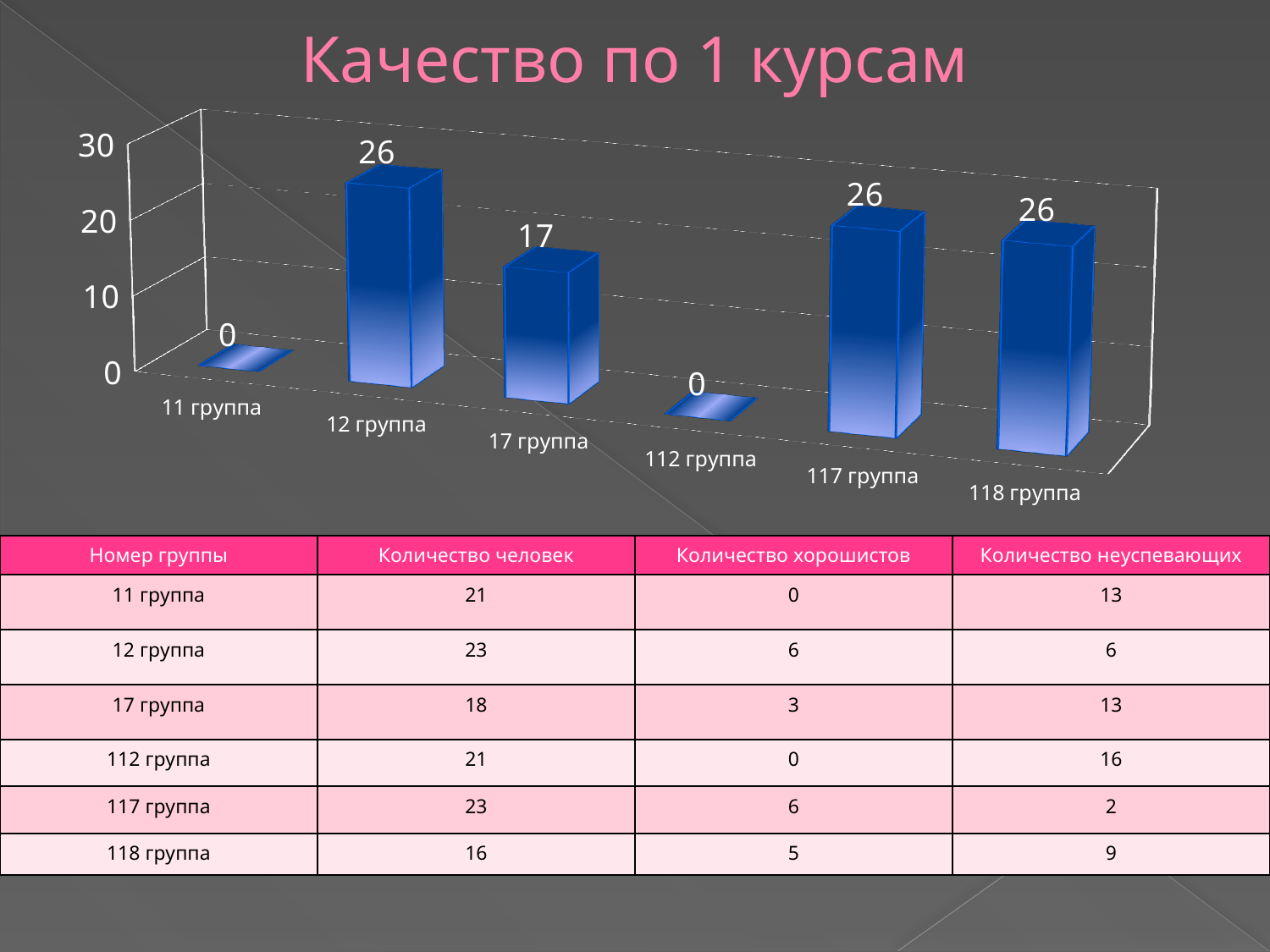
What is the difference between the values for 12 группа and 17 группа? 9 Is the value for 17 группа greater or less than 10? greater What is the value for 117 группа? 26 How many groups are shown on the chart? 6 What is the value for 118 группа? 26 What kind of chart is shown on the slide? bar chart What is the value for 12 группа? 26 What is the value for 112 группа? 0 Which is larger, the value for 12 группа or the value for 17 группа? 12 группа What is the title of the chart? Качество по 1 курсам What is the value for 17 группа? 17 What is the value for 11 группа? 0